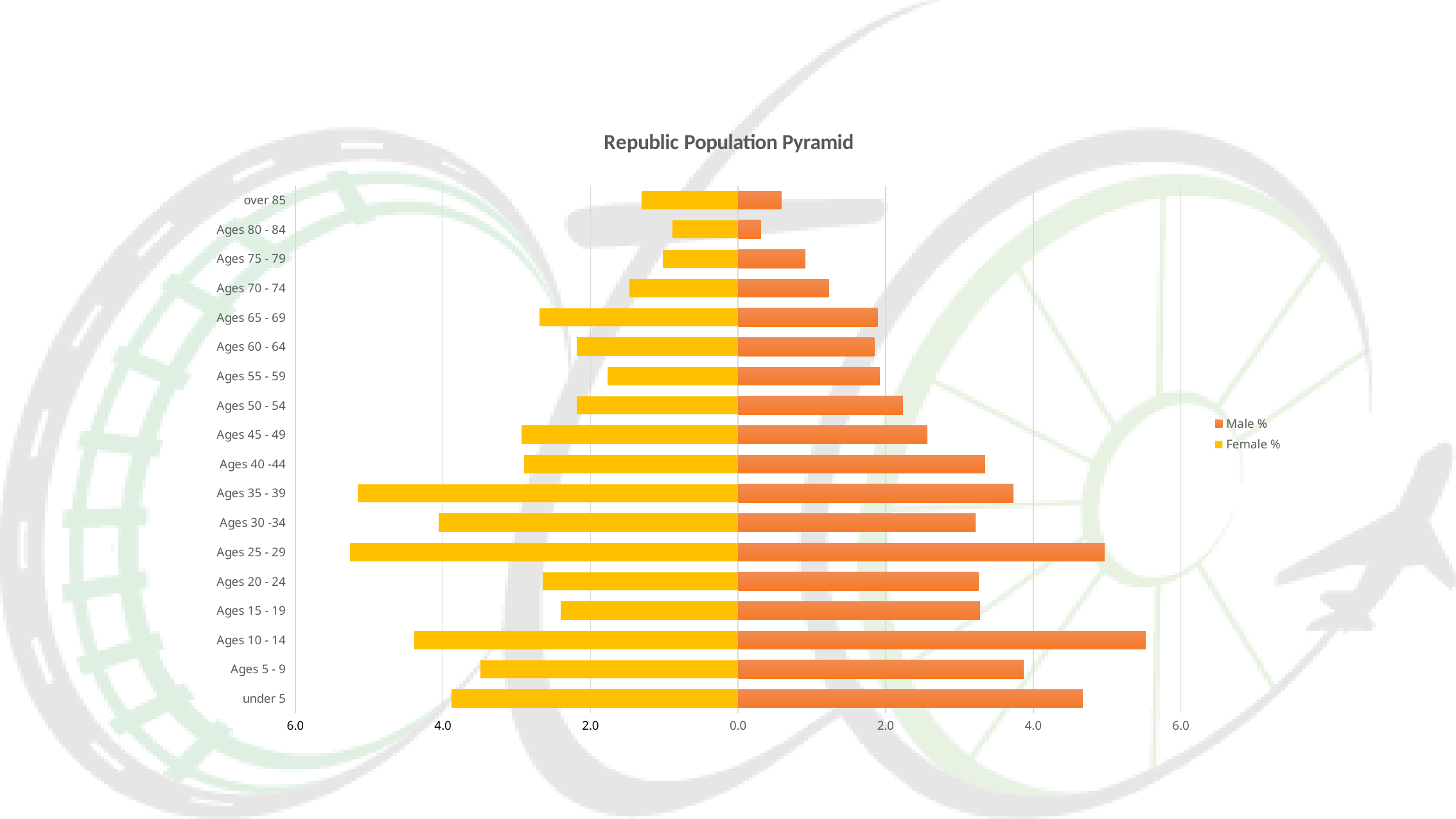
How many series does the legend list? 2 Is the Female % value for Ages 35 - 39 greater or less than 4.0? greater Which colour represents the Female % series? yellow Is the Male % value for Ages 10 - 14 greater or less than 4.0? greater Which age group has the highest Male % value? Ages 10 - 14 What is the title of the chart? Republic Population Pyramid What kind of chart is shown on the slide? bar chart Is the Female % value for Ages 65 - 69 greater or less than 2.0? greater Which age group has the lowest Male % value? Ages 80 - 84 Which is larger, the Female % value for Ages 25 - 29 or for Ages 30 -34? Ages 25 - 29 How many age categories are shown on the chart? 18